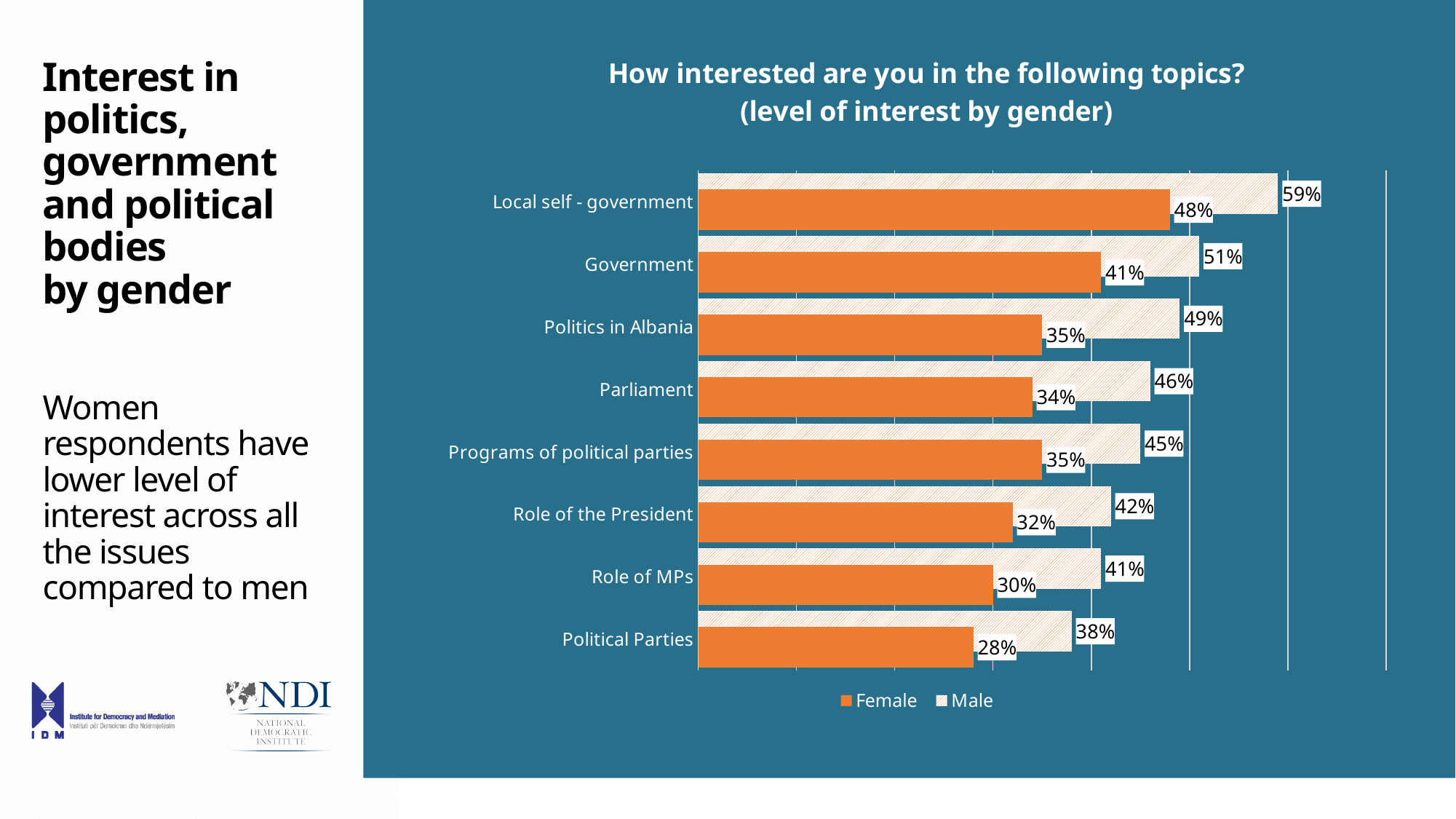
What is the difference between the Male and Female values for Parliament? 12% Which topic has the lowest Female value? Political Parties What kind of chart is shown on the slide? Bar chart Which is larger, the Female value for Role of the President or the Female value for Political Parties? Role of the President What is the Female value for Role of MPs? 30% What is the Male value for Political Parties? 38% How many series does the legend list? 2 What is the difference between the Male and Female values for Government? 10% What is the Male value for Politics in Albania? 49% What is the Female value for Local self - government? 48% Which topic has the highest Male value? Local self - government How many topics are shown in the chart? 8